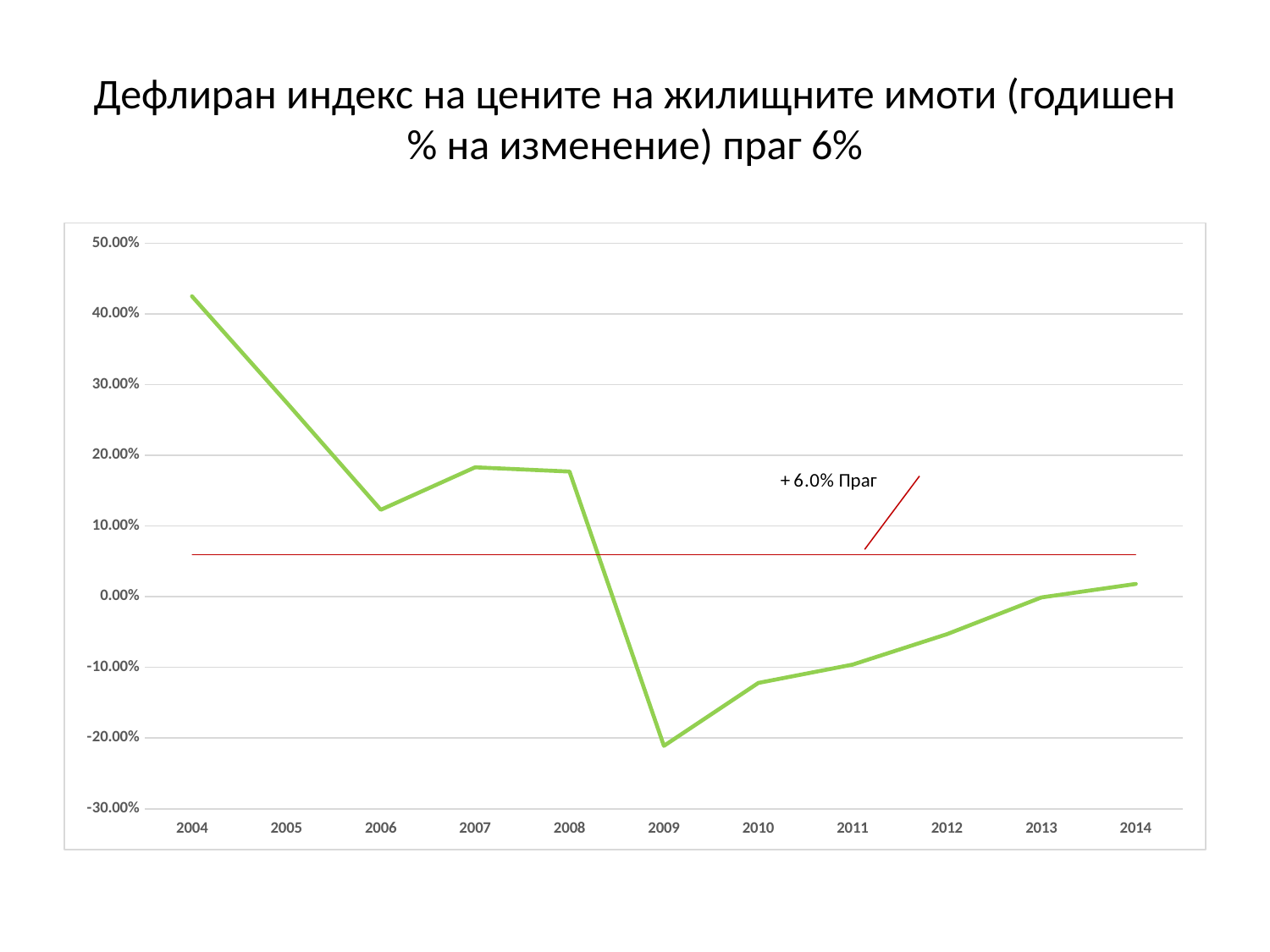
Is the value for 2012 greater or less than 0.00%? less Which is larger, the value for 2004 or the value for 2006? 2004 Do the values rise or fall from 2009 to 2014? rise Is the value for 2009 greater or less than -10.00%? less Is the value for 2004 greater or less than 40.00%? greater Which year has the lowest value? 2009 Which year has the highest value? 2004 What kind of chart is shown on the slide? line chart What label is attached to the horizontal threshold line on the chart? + 6.0% Праг How many years are plotted along the x axis? 11